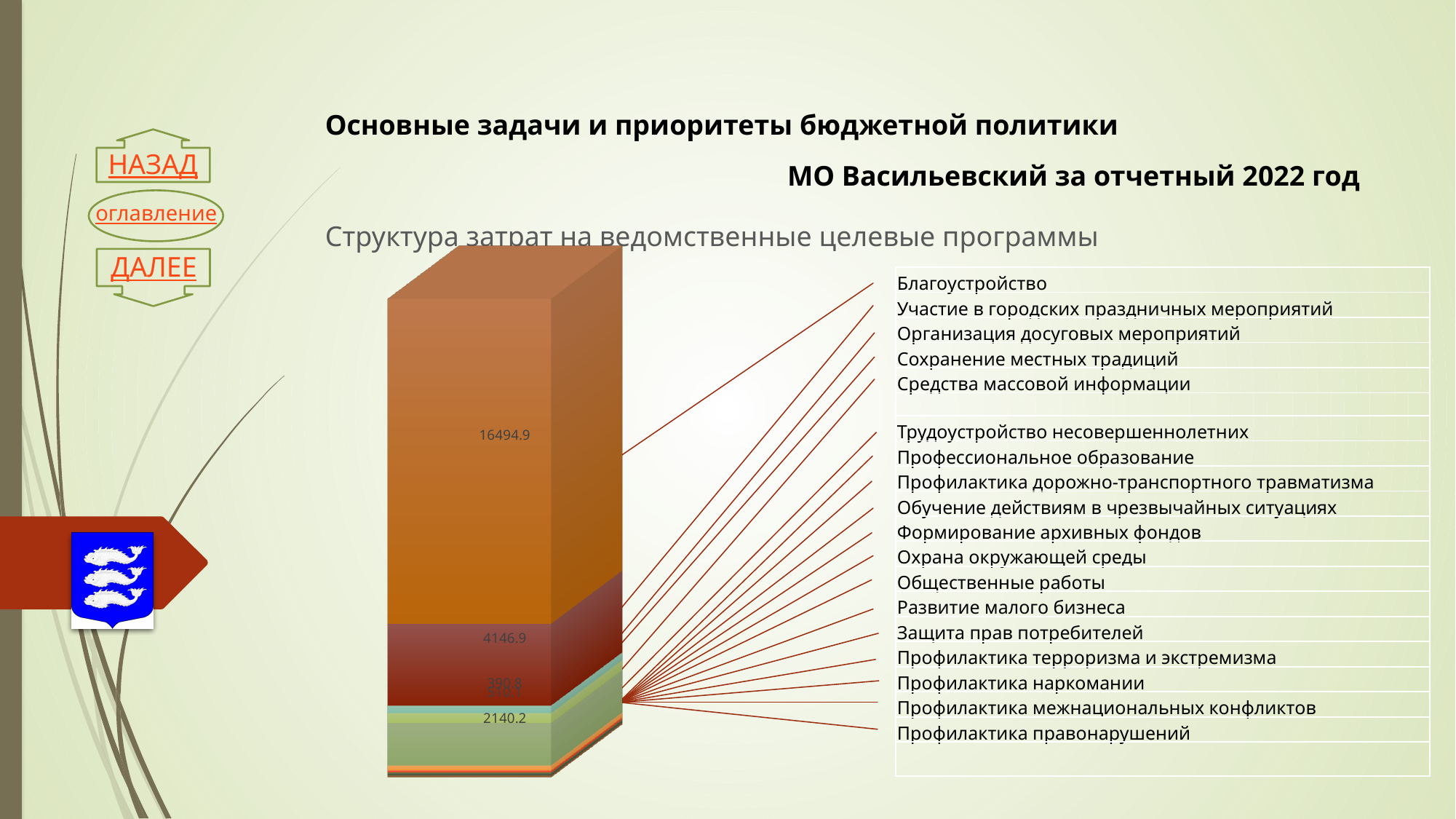
How many bars are plotted in the chart? 1 What kind of chart is shown on the slide? stacked bar chart What is the difference between the segment labelled 16494.9 and the segment labelled 4146.9? 12348.0 What is the value labelled on the second-largest segment of the bar? 4146.9 What is the title of the chart? Структура затрат на ведомственные целевые программы What is the value labelled on the green segment near the bottom of the bar? 2140.2 Is the largest segment of the bar greater or less than 10000? greater How many entries does the chart's legend list? 18 What is the difference between the segment labelled 4146.9 and the segment labelled 2140.2? 2006.7 What is the largest value labelled on the stacked bar? 16494.9 Which is larger, the segment labelled 4146.9 or the segment labelled 2140.2? 4146.9 What is the first entry listed in the chart's legend? Благоустройство